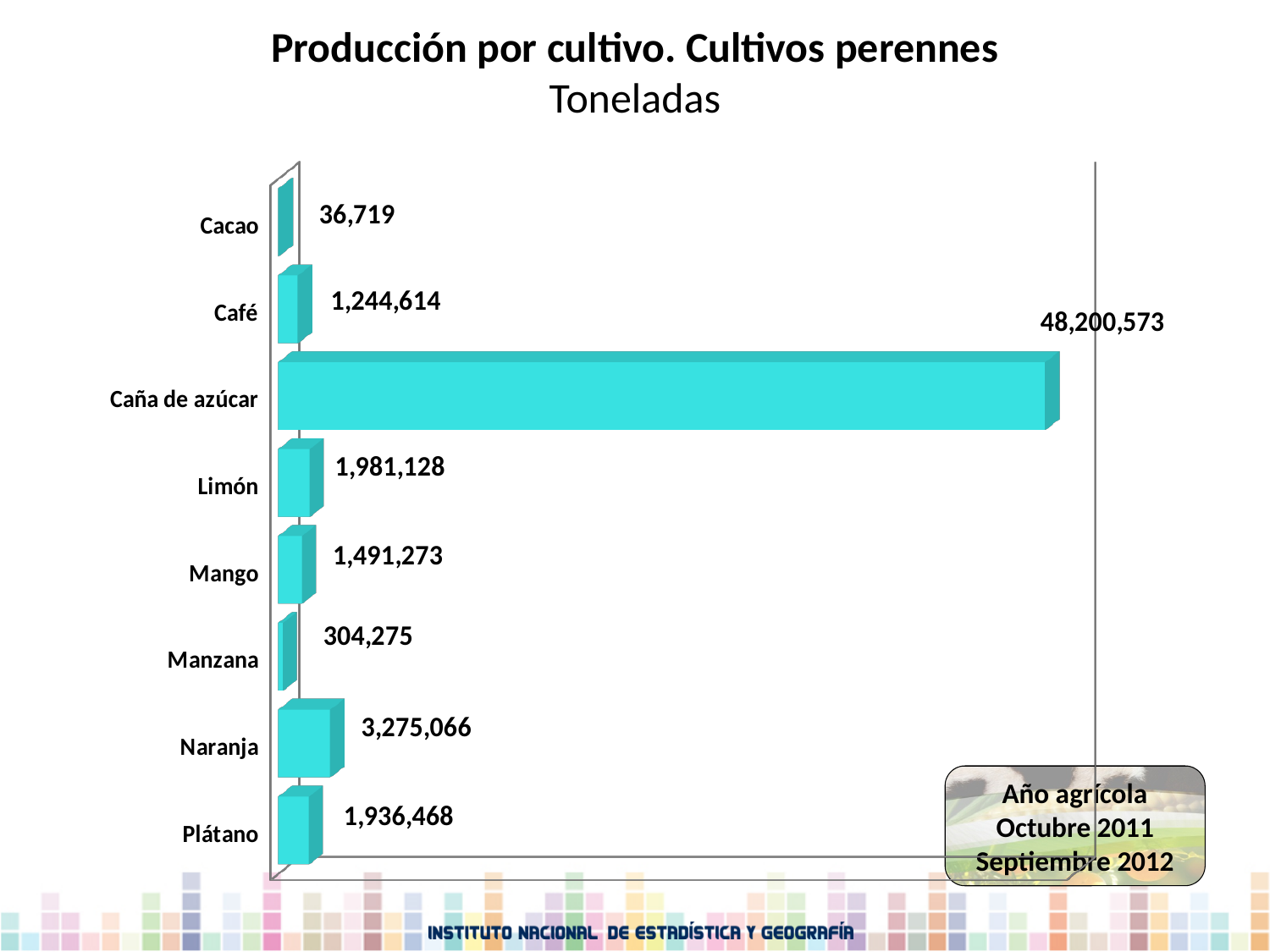
What is the production value for Cacao? 36,719 What is the difference between the production of Naranja and Plátano? 1,338,598 What type of chart is shown on the slide? Bar chart What is the production value for Naranja? 3,275,066 What unit of measurement is given in the chart's subtitle? Toneladas What is the production value for Caña de azúcar? 48,200,573 How many crops are shown in the chart? 8 Which crop has the lowest production? Cacao Which has a higher production, Mango or Café? Mango What is the difference between the production of Café and Manzana? 940,339 What is the production value for Manzana? 304,275 Which crop has the highest production? Caña de azúcar